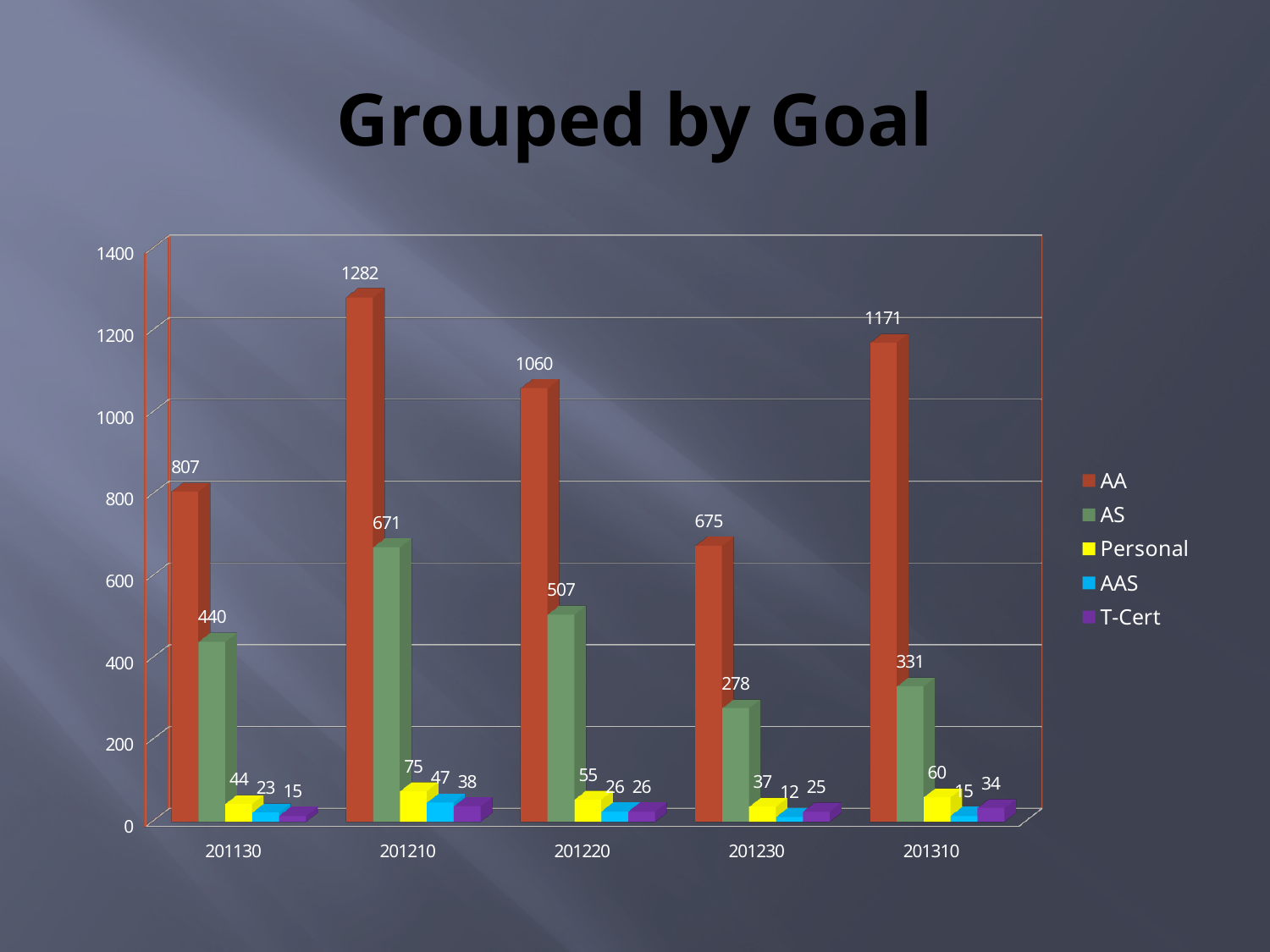
What is the T-Cert value for 201230? 25 Which category has the lowest AS value? 201230 Which is larger, the AAS value for 201210 or the AAS value for 201310? 201210 What is the AS value for 201310? 331 What is the Personal value for 201220? 55 How many series does the legend list? 5 What is the title of the slide? Grouped by Goal What kind of chart is shown on the slide? bar chart What is the difference between the AA and AS values for 201130? 367 How many categories are shown on the x axis? 5 What is the AA value for 201210? 1282 Which category has the highest AA value? 201210